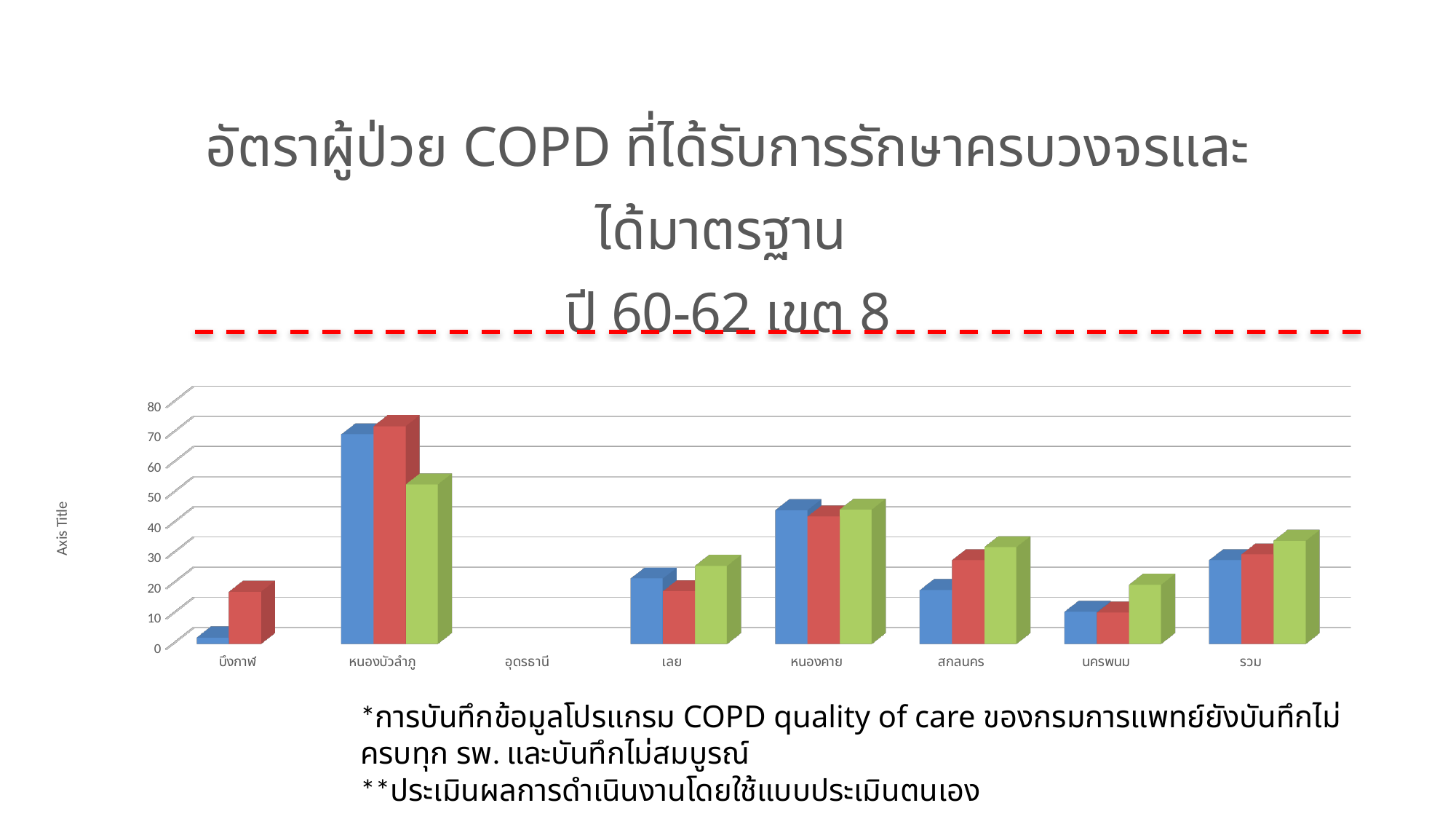
What kind of chart is shown on the slide? bar chart How many categories are shown on the x axis of the chart? 8 Which category has no visible bars in the chart? อุดรธานี Is the value of the blue bar for หนองคาย greater or less than 30? greater Which is larger for สกลนคร, the blue bar or the green bar? the green bar Which is larger, the blue bar for หนองบัวลำภู or the blue bar for หนองคาย? หนองบัวลำภู Is the value of the blue bar for หนองบัวลำภู greater or less than 60? greater How many bars are plotted for the category หนองบัวลำภู? 3 What is the label shown on the vertical axis of the chart? Axis Title Which category has the tallest bars in the chart? หนองบัวลำภู Is the value of the blue bar for บึงกาฬ greater or less than 10? less